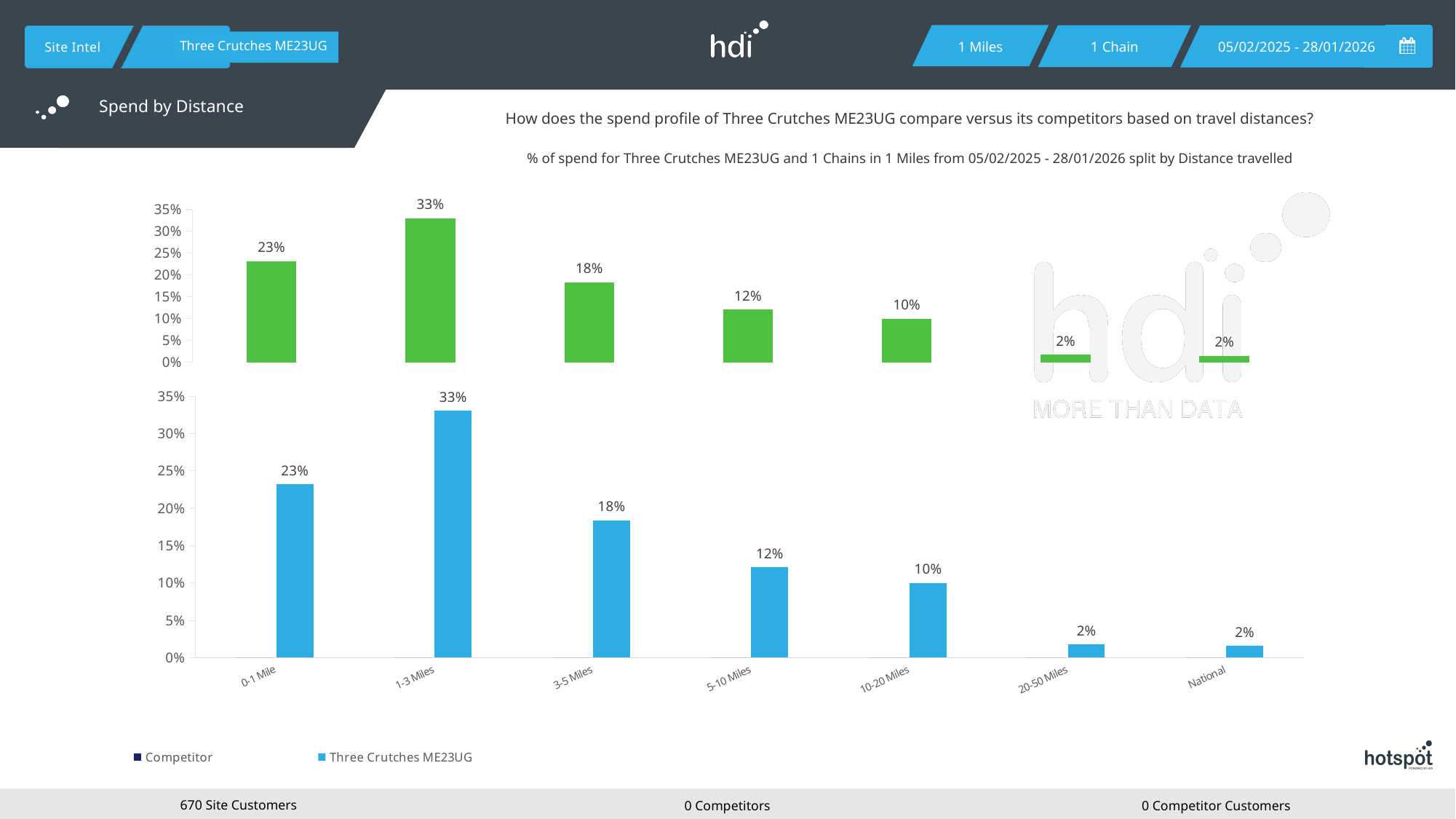
On the bottom chart, what is the difference between the values for 1-3 Miles and 3-5 Miles? 15% On the bottom chart, what is the value for 5-10 Miles? 12% On the bottom chart, what is the value for 0-1 Mile? 23% On the bottom chart, which is larger, the value for 0-1 Mile or the value for 10-20 Miles? 0-1 Mile On the bottom chart, how many distance bands are shown on the x axis? 7 On the bottom chart, what is the value for 1-3 Miles? 33% How many series does the legend at the bottom of the slide list? 2 On the bottom chart, do the values rise or fall from 1-3 Miles to National? Fall What kind of chart is the bottom chart? Bar chart On the bottom chart, which distance band has the highest value? 1-3 Miles On the bottom chart, what is the value for National? 2% On the top chart, what is the value of the tallest bar? 33%